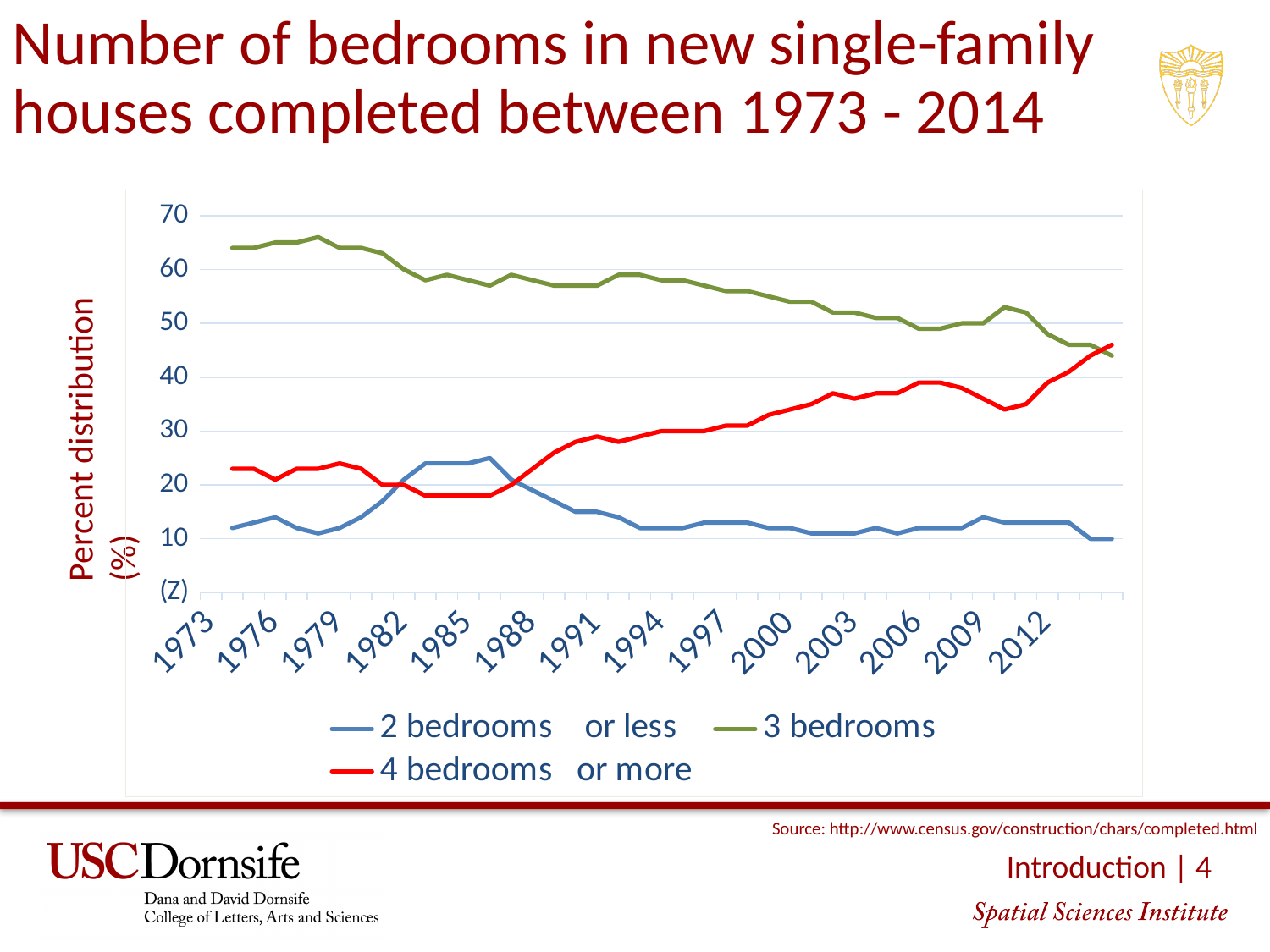
What is the label of the vertical axis? Percent distribution (%) Does the 3 bedrooms series generally rise or fall from 1973 to 2014? Fall In 2012, which is larger: 4 bedrooms or more, or 2 bedrooms or less? 4 bedrooms or more Does the 4 bedrooms or more series generally rise or fall from 1973 to 2014? Rise Is the value for 4 bedrooms or more in 2012 greater or less than 30? greater Is the value for 3 bedrooms in 1973 greater or less than 60? greater How many series does the legend list? 3 Is the value for 2 bedrooms or less in 1973 greater or less than 20? less Which series has the lowest value in 1973? 2 bedrooms or less What kind of chart is shown on the slide? Line chart Which series has the highest value in 1973? 3 bedrooms